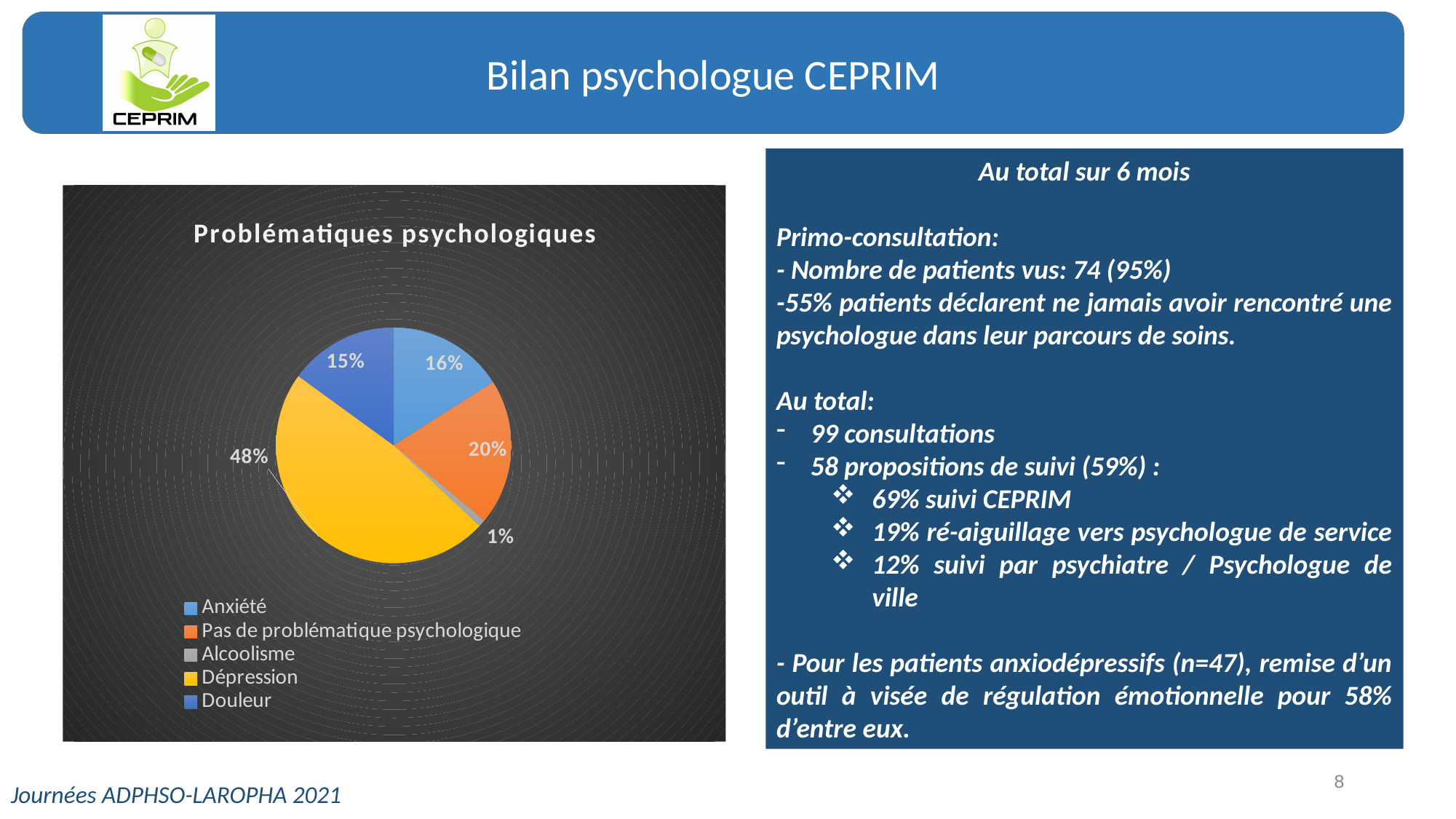
What share of the pie does Dépression represent? 48% What share of the pie does Alcoolisme represent? 1% Which category has the smallest slice of the pie? Alcoolisme Which is larger, the share for Anxiété or the share for Douleur? Anxiété What share of the pie does Anxiété represent? 16% Which category has the largest slice of the pie? Dépression What type of chart is shown on the slide? pie chart What is the title of the chart? Problématiques psychologiques What is the difference between the shares for Dépression and Pas de problématique psychologique? 28% How many categories does the pie chart show? 5